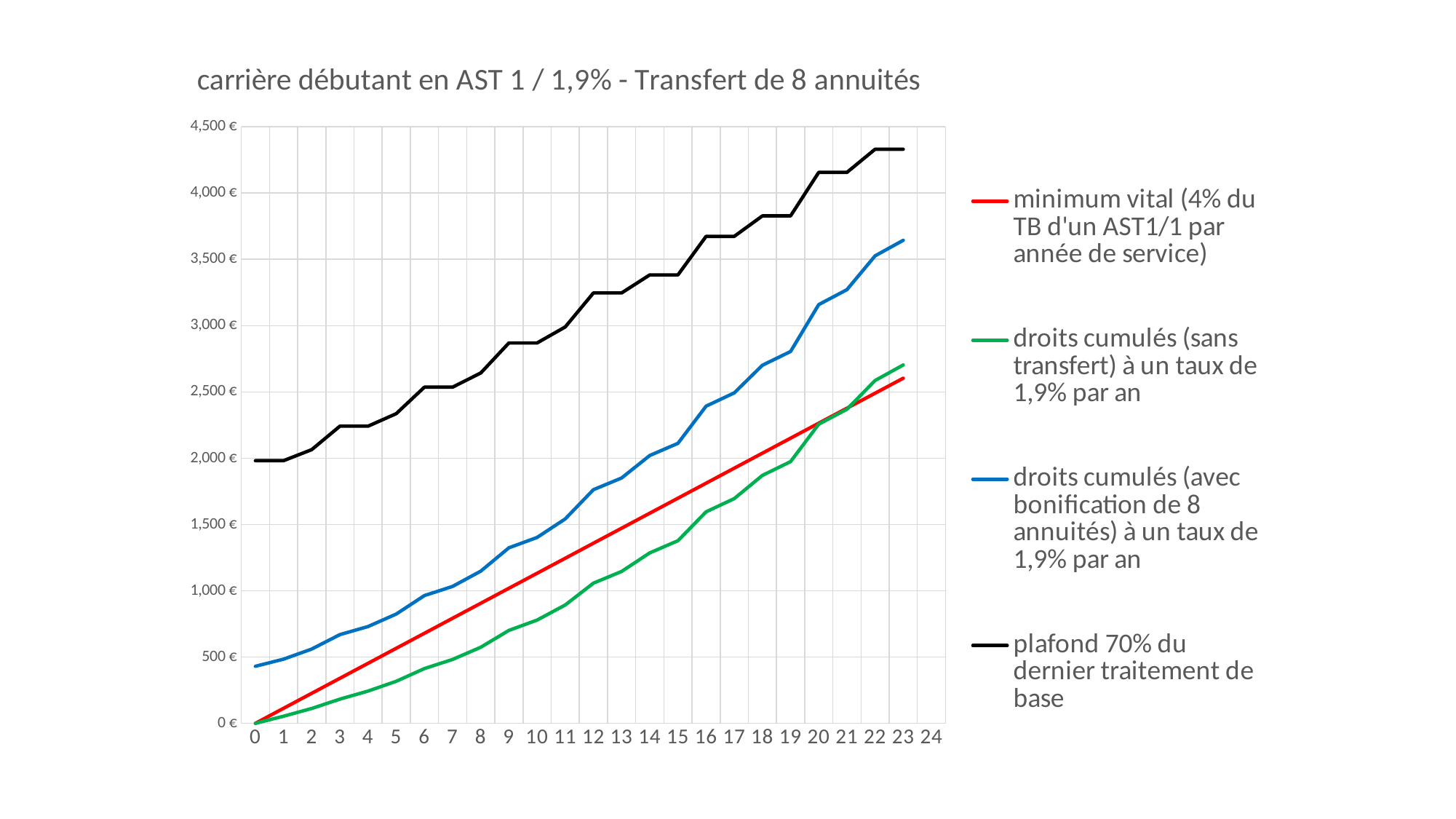
What is the title of the chart? carrière débutant en AST 1 / 1,9% - Transfert de 8 annuités How many series does the legend list? 4 Is the value of 'plafond 70% du dernier traitement de base' at year 23 greater or less than 4,000 €? greater Is the value of 'droits cumulés (avec bonification de 8 annuités)' at year 23 greater or less than 3,500 €? greater Which colour is used for the series 'plafond 70% du dernier traitement de base'? black Is the value of 'droits cumulés (sans transfert)' at year 10 greater or less than 1,000 €? less Does the 'plafond 70% du dernier traitement de base' series rise or fall from year 0 to year 23? rise What is the value of the 'minimum vital' series at year 0? 0 € At year 10, which is higher: 'minimum vital' or 'droits cumulés (sans transfert)'? minimum vital Which series has the highest values across the whole chart? plafond 70% du dernier traitement de base What kind of chart is shown on the slide? line chart